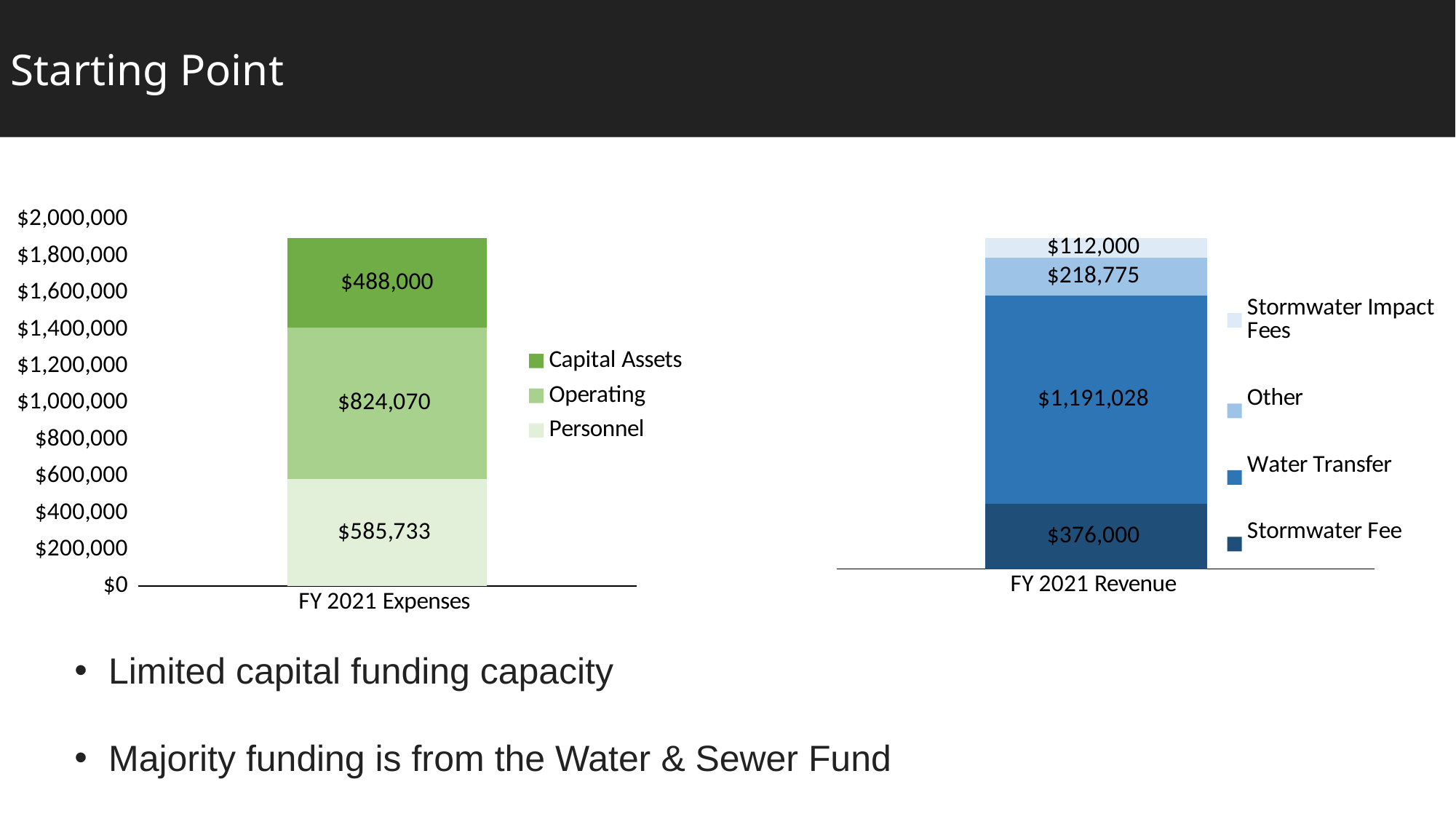
In the right chart (FY 2021 Revenue), what is the value for Water Transfer? $1,191,028 In the right chart (FY 2021 Revenue), what is the value for Stormwater Impact Fees? $112,000 In the left chart (FY 2021 Expenses), what is the value for Personnel? $585,733 In the right chart (FY 2021 Revenue), which is larger, Stormwater Fee or Other? Stormwater Fee How many series does the legend of the right chart (FY 2021 Revenue) list? 4 In the right chart (FY 2021 Revenue), which series has the smallest value? Stormwater Impact Fees In the left chart (FY 2021 Expenses), what is the total of the stacked bar? $1,897,803 In the right chart (FY 2021 Revenue), what is the total of the stacked bar? $1,897,803 In the left chart (FY 2021 Expenses), what is the value for Operating? $824,070 What kind of chart is the left chart (FY 2021 Expenses)? Stacked bar chart In the left chart (FY 2021 Expenses), what is the difference between Operating and Capital Assets? $336,070 In the left chart (FY 2021 Expenses), which series has the largest value? Operating